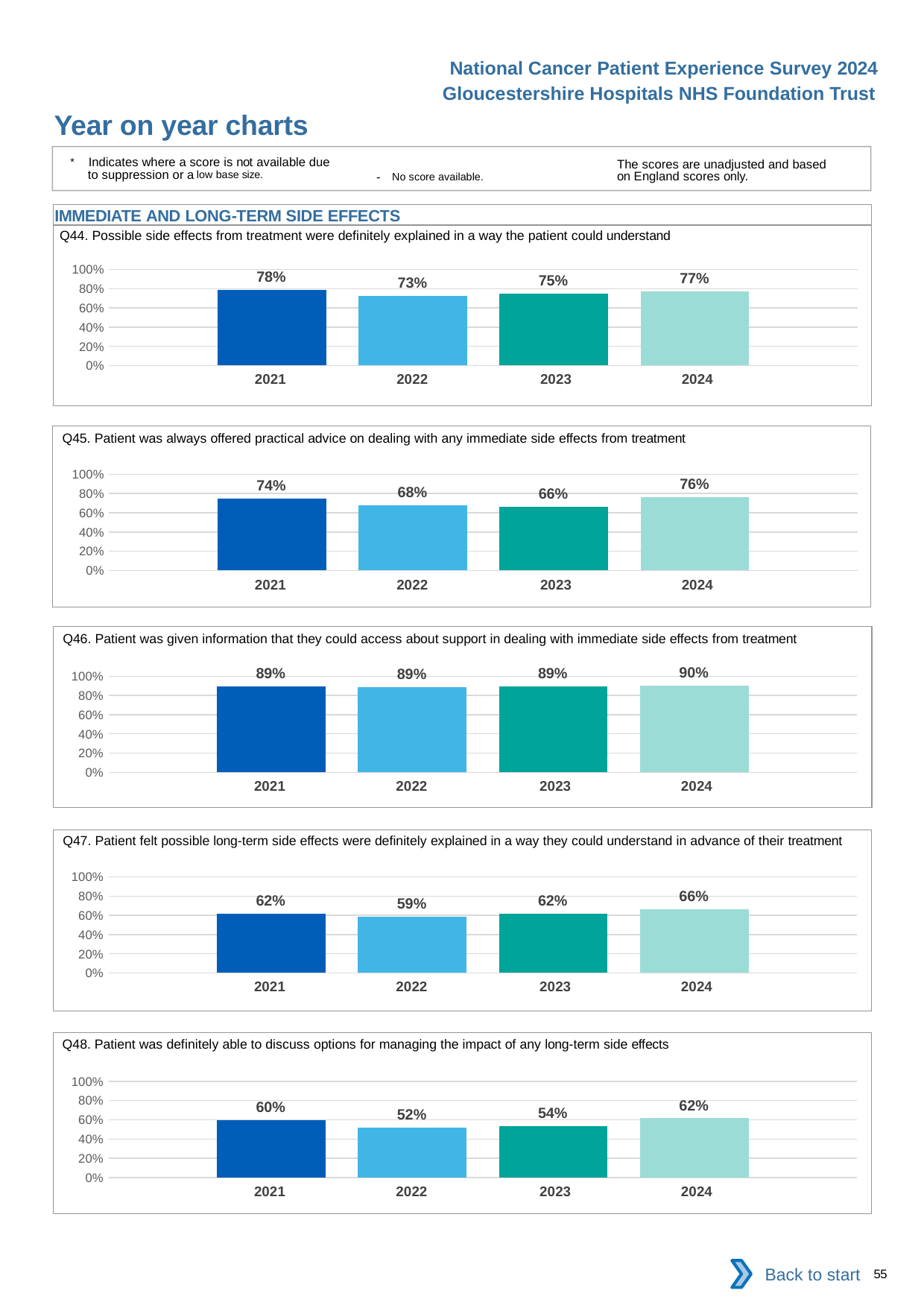
In the Q47 chart, which is larger, the value for 2021 or the value for 2024? 2024 In the Q45 chart, what is the value for 2024? 76% What kind of chart is the Q48 chart? Bar chart In the Q48 chart, what is the value for 2021? 60% In the Q48 chart, what is the difference between the 2021 and 2022 values? 8% In the Q45 chart, what is the difference between the 2024 and 2023 values? 10% In the Q46 chart, what is the value for 2024? 90% In the Q47 chart, what is the value for 2022? 59% In the Q46 chart, how many years are shown on the x axis? 4 In the Q44 chart, what is the value for 2022? 73% In the Q44 chart, which year has the highest value? 2021 In the Q45 chart, which year has the lowest value? 2023